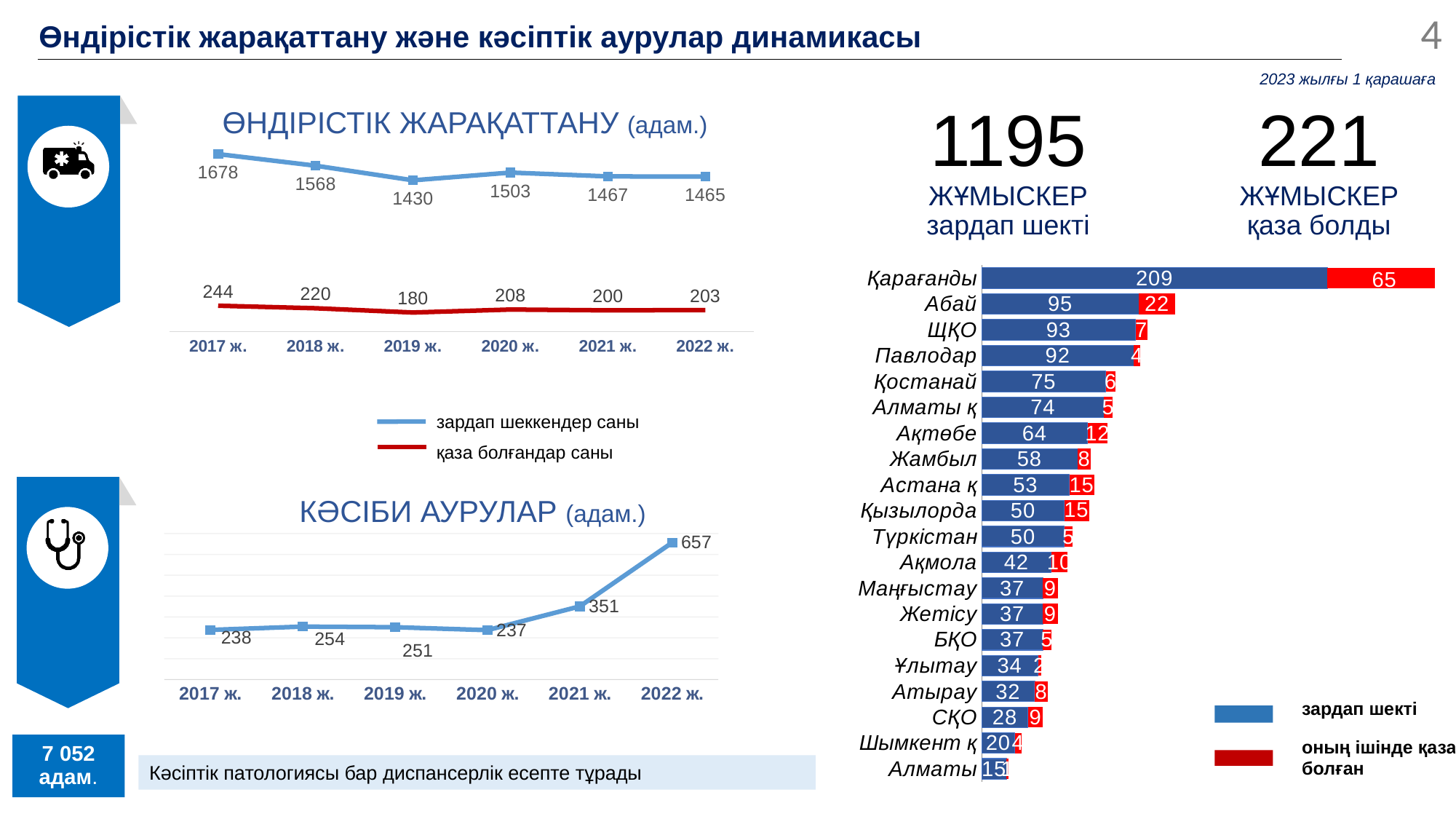
In the regional bar chart on the right, what is the "зардап шекті" value for Абай? 95 In the "ӨНДІРІСТІК ЖАРАҚАТТАНУ (адам.)" chart, what is the difference between the "зардап шеккендер саны" values for 2017 ж. and 2018 ж.? 110 In the regional bar chart on the right, which is larger: the "оның ішінде қаза болған" value for Ақтөбе or for Жамбыл? Ақтөбе In the "КӘСІБИ АУРУЛАР (адам.)" chart, what is the value for 2021 ж.? 351 What kind of chart is the "КӘСІБИ АУРУЛАР (адам.)" chart? line chart In the "ӨНДІРІСТІК ЖАРАҚАТТАНУ (адам.)" chart, what is the value of "қаза болғандар саны" for 2019 ж.? 180 In the "КӘСІБИ АУРУЛАР (адам.)" chart, which year has the highest value? 2022 ж. In the "КӘСІБИ АУРУЛАР (адам.)" chart, what is the difference between the values for 2022 ж. and 2021 ж.? 306 In the "ӨНДІРІСТІК ЖАРАҚАТТАНУ (адам.)" chart, which year has the lowest value for "зардап шеккендер саны"? 2019 ж. How many series does the legend of the "ӨНДІРІСТІК ЖАРАҚАТТАНУ (адам.)" chart list? 2 In the "ӨНДІРІСТІК ЖАРАҚАТТАНУ (адам.)" chart, what is the value of "зардап шеккендер саны" for 2017 ж.? 1678 In the regional bar chart on the right, which region has the highest "зардап шекті" value? Қарағанды